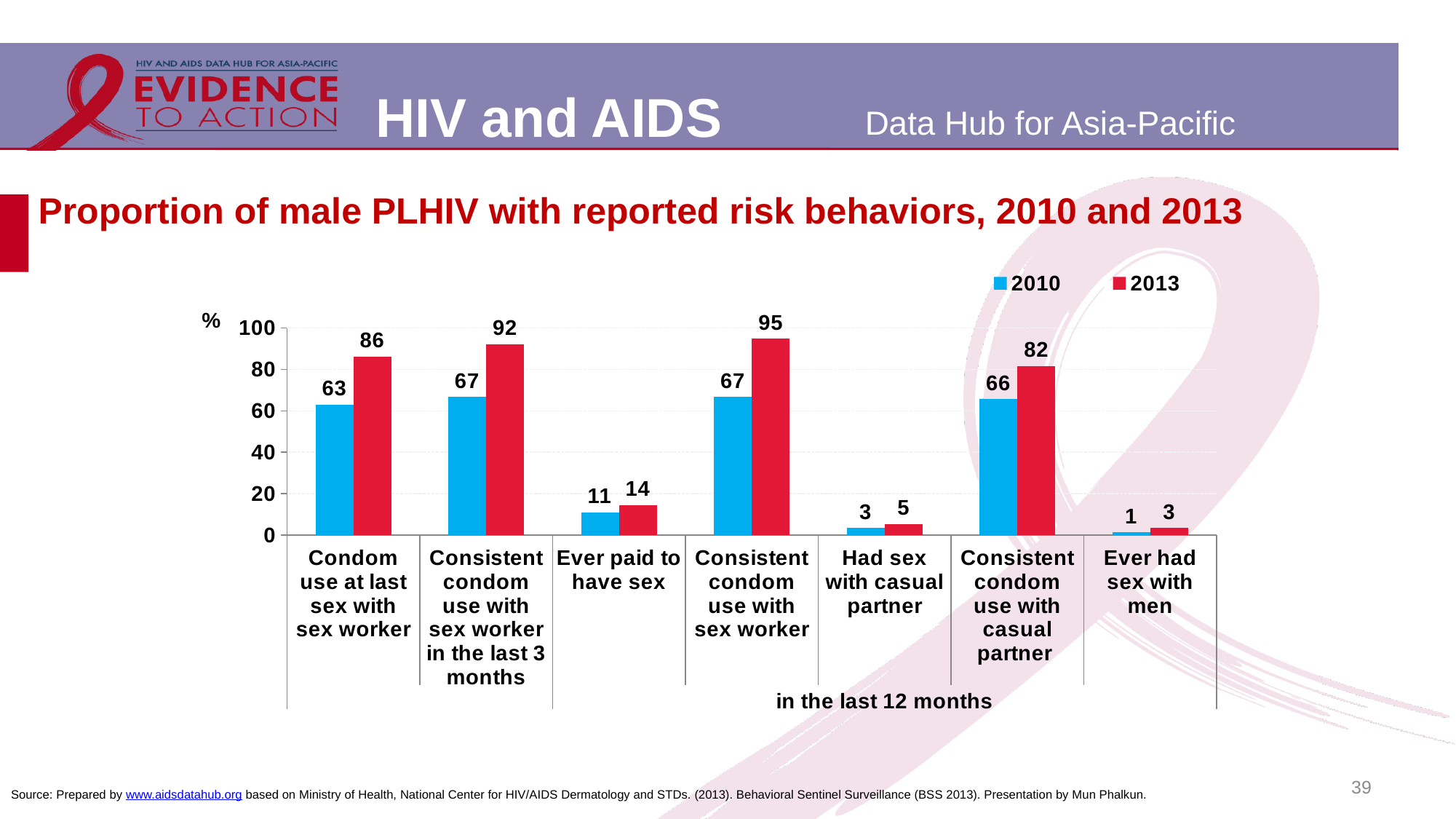
What kind of chart is shown on the slide? Bar chart What is the 2013 value for 'Consistent condom use with sex worker in the last 3 months'? 92 What is the 2013 value for 'Had sex with casual partner'? 5 How many series does the legend list? 2 Which colour represents the 2013 series? Red Which category has the lowest 2010 value? Ever had sex with men Which category has the highest 2013 value? Consistent condom use with sex worker How many categories are shown on the x axis? 7 What is the 2010 value for 'Condom use at last sex with sex worker'? 63 What is the difference between the 2013 and 2010 values for 'Condom use at last sex with sex worker'? 23 What is the 2010 value for 'Consistent condom use with casual partner'? 66 Which is larger: the 2010 value for 'Ever paid to have sex' or the 2010 value for 'Had sex with casual partner'? Ever paid to have sex